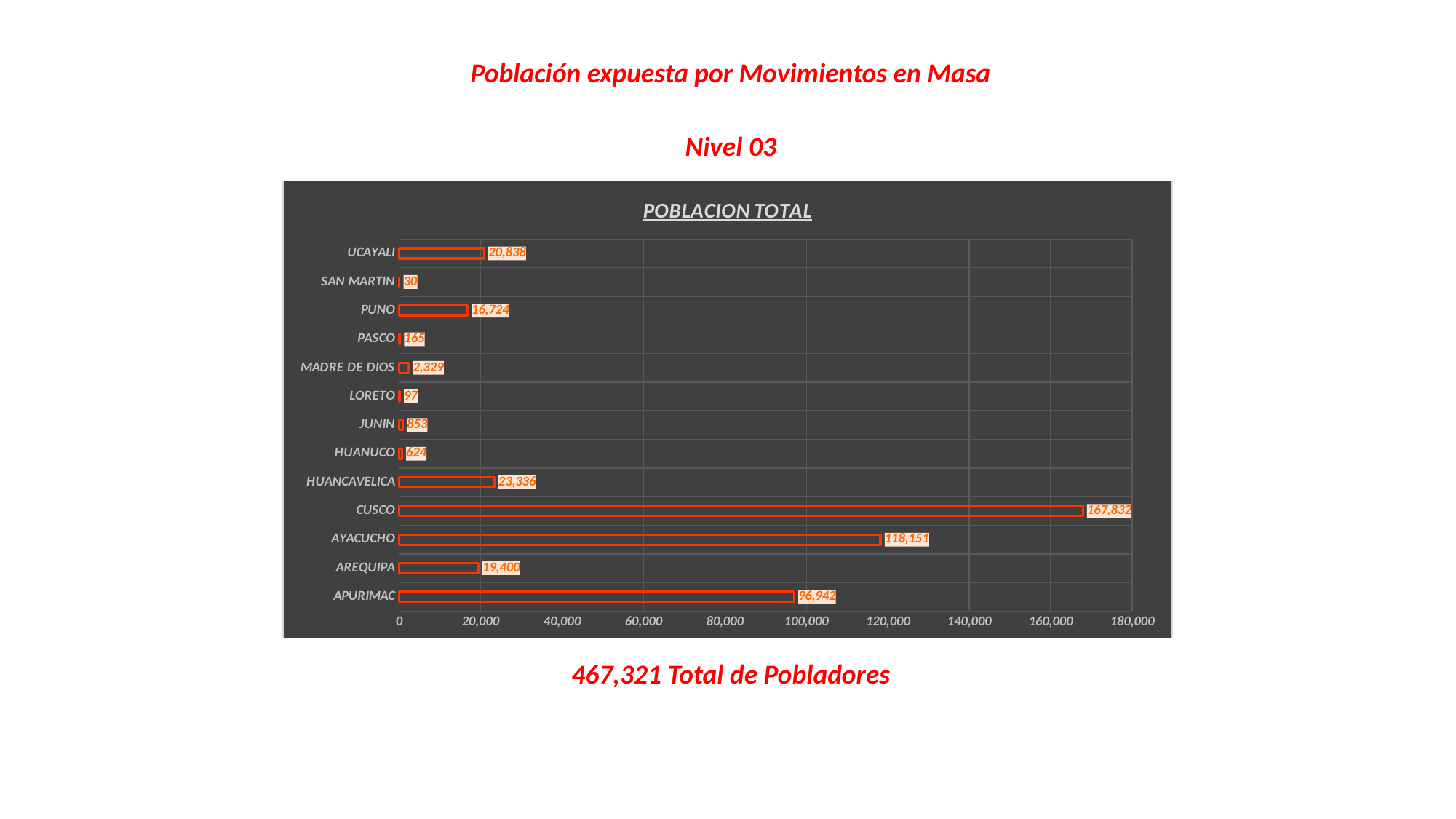
How many categories are shown in the chart? 13 Is the value for APURIMAC greater or less than 100,000? less Which category has the lowest value? SAN MARTIN What is the difference between the values for HUANCAVELICA and UCAYALI? 2,498 What is the value for MADRE DE DIOS? 2,329 Which category has the highest value? CUSCO What kind of chart is shown on the slide? bar chart What is the value for HUANCAVELICA? 23,336 Which is larger, the value for APURIMAC or the value for AYACUCHO? AYACUCHO What is the title of the chart? POBLACION TOTAL What is the difference between the values for CUSCO and AYACUCHO? 49,681 What is the value for CUSCO? 167,832